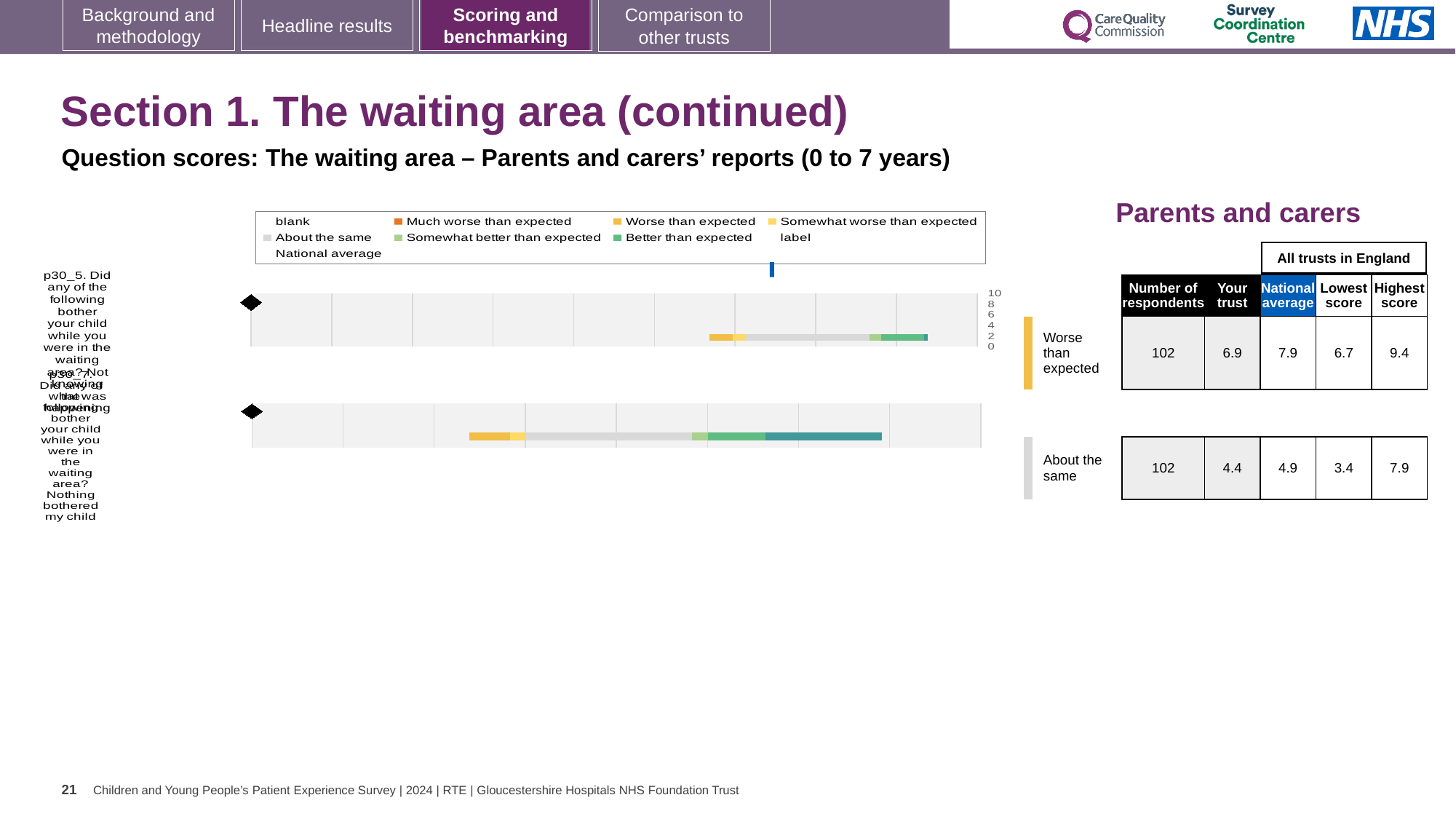
How many entries does the chart legend list? 9 For the question rated 'Worse than expected', which is larger: the 'Your trust' score or the national average? National average In the table, what is the difference between the highest score and the lowest score for the question rated 'Worse than expected'? 2.7 What colour does the legend use for 'Much worse than expected'? orange In the table, what is the national average for the question rated 'About the same'? 4.9 In the table, what is the 'Your trust' score for the question rated 'Worse than expected'? 6.9 In the table, what is the lowest score for the question rated 'About the same'? 3.4 What kind of chart is shown on the slide? bar chart How many question bars are plotted in the chart? 2 In the table, what is the difference between the 'Your trust' score and the national average for the question rated 'About the same'? 0.5 What colour does the legend use for 'About the same'? grey In the table, what is the number of respondents for the question rated 'Worse than expected'? 102